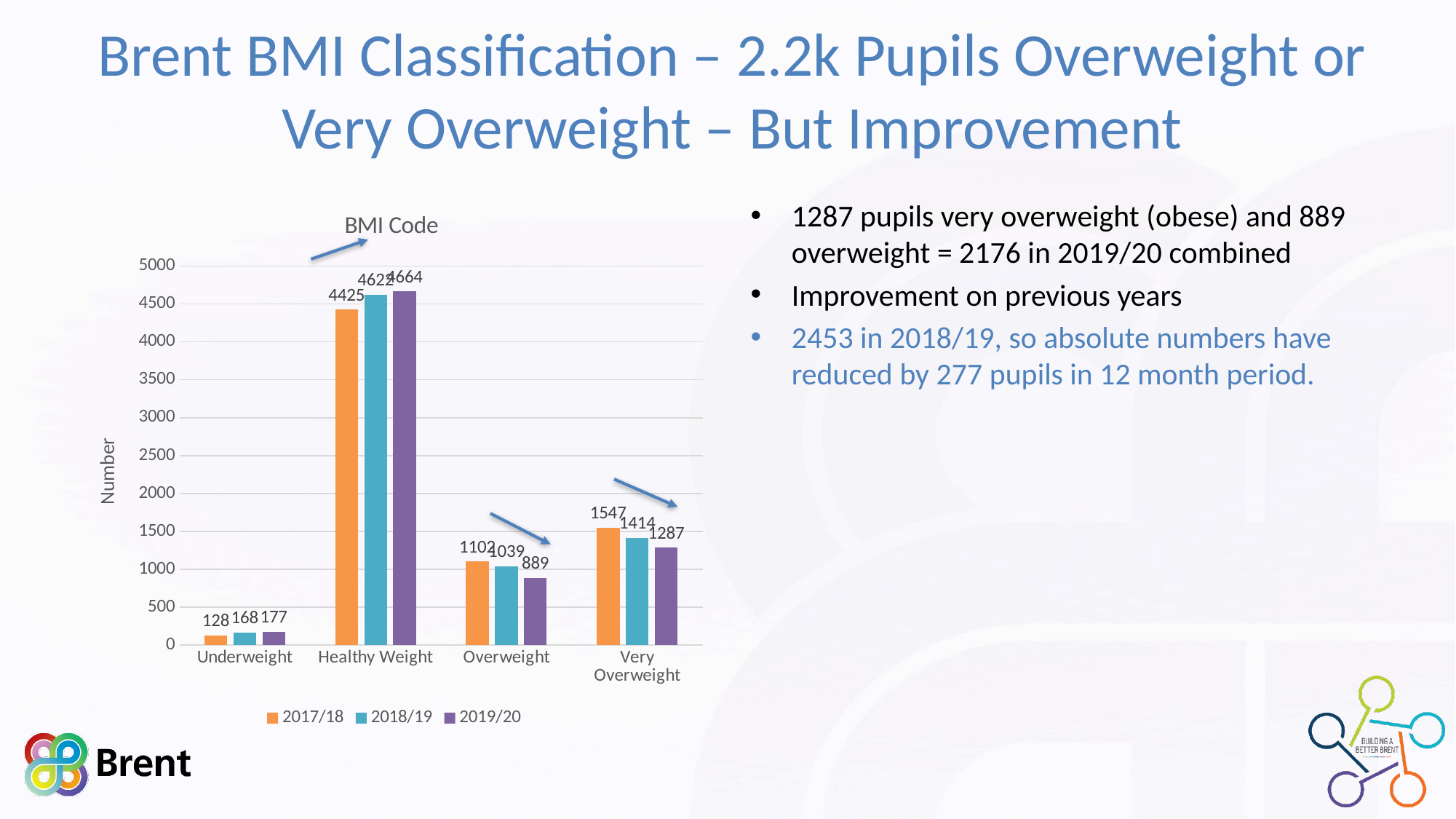
Do the Very Overweight values rise or fall from 2017/18 to 2019/20? Fall Which category has the lowest value in 2017/18? Underweight Which category has the highest value in 2019/20? Healthy Weight What is the value for Underweight in 2018/19? 168 What is the value for Healthy Weight in 2017/18? 4425 What is the difference between the Overweight values for 2017/18 and 2019/20? 213 How many series does the chart legend list? 3 Which is larger: Very Overweight in 2018/19 or Overweight in 2017/18? Very Overweight in 2018/19 What is the value for Very Overweight in 2019/20? 1287 What is the title of the chart? BMI Code What type of chart is shown on the slide? Bar chart How many BMI categories are shown on the x axis? 4